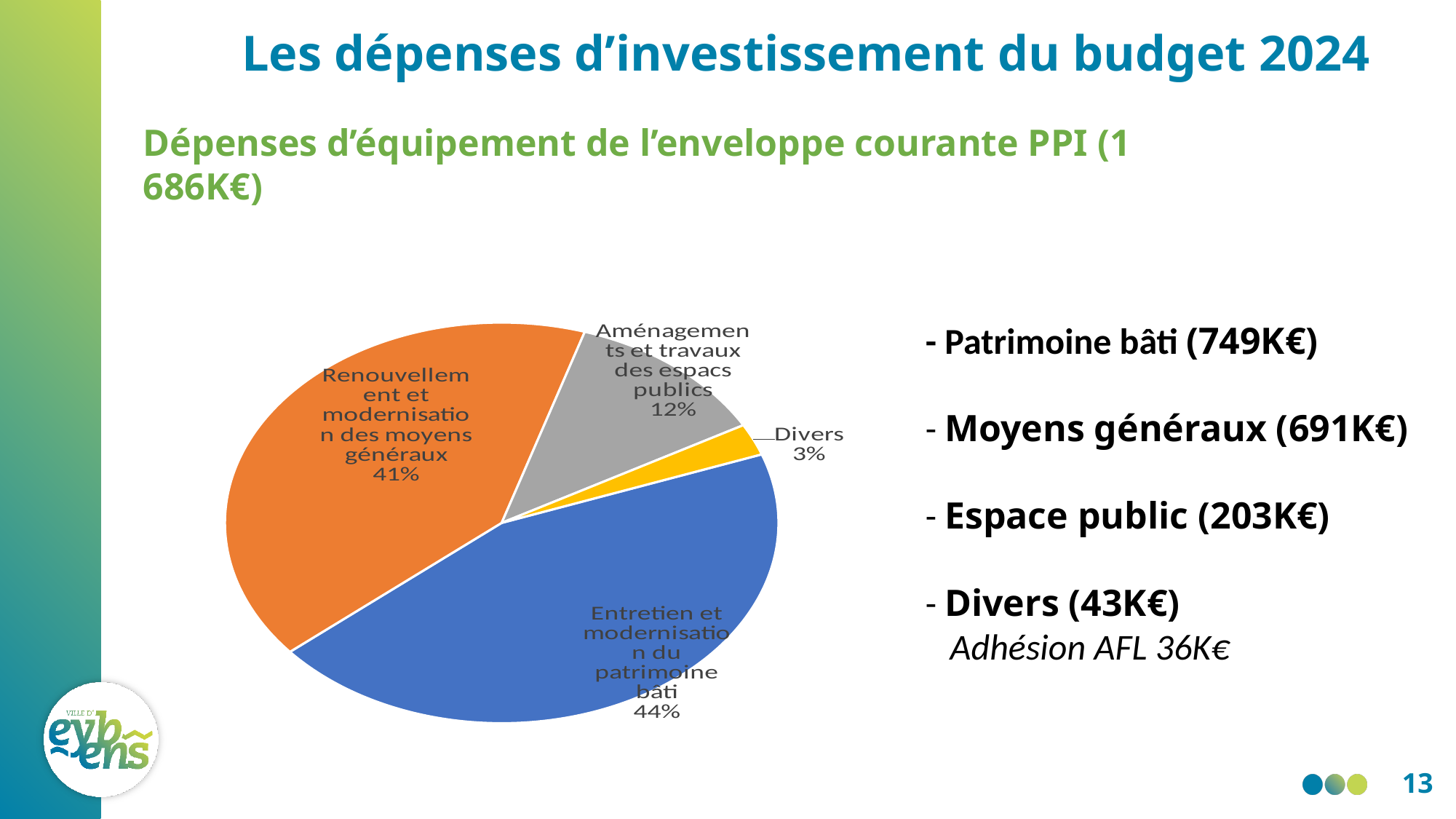
What is the difference in percentage points between "Aménagements et travaux des espaces publics" and "Divers"? 9 percentage points What percentage is shown for the "Divers" slice? 3% What is the difference in percentage points between "Entretien et modernisation du patrimoine bâti" and "Renouvellement et modernisation des moyens généraux"? 3 percentage points What percentage is shown for "Aménagements et travaux des espaces publics"? 12% What colour is the "Divers" slice of the pie chart? Yellow Which slice of the pie chart is the largest? Entretien et modernisation du patrimoine bâti What share of the pie does "Entretien et modernisation du patrimoine bâti" represent? 44% Which slice of the pie chart is the smallest? Divers Which is larger: the share for "Aménagements et travaux des espaces publics" or the share for "Divers"? Aménagements et travaux des espaces publics How many slices does the pie chart have? 4 What share of the pie does "Renouvellement et modernisation des moyens généraux" represent? 41% What kind of chart is shown on the slide? Pie chart